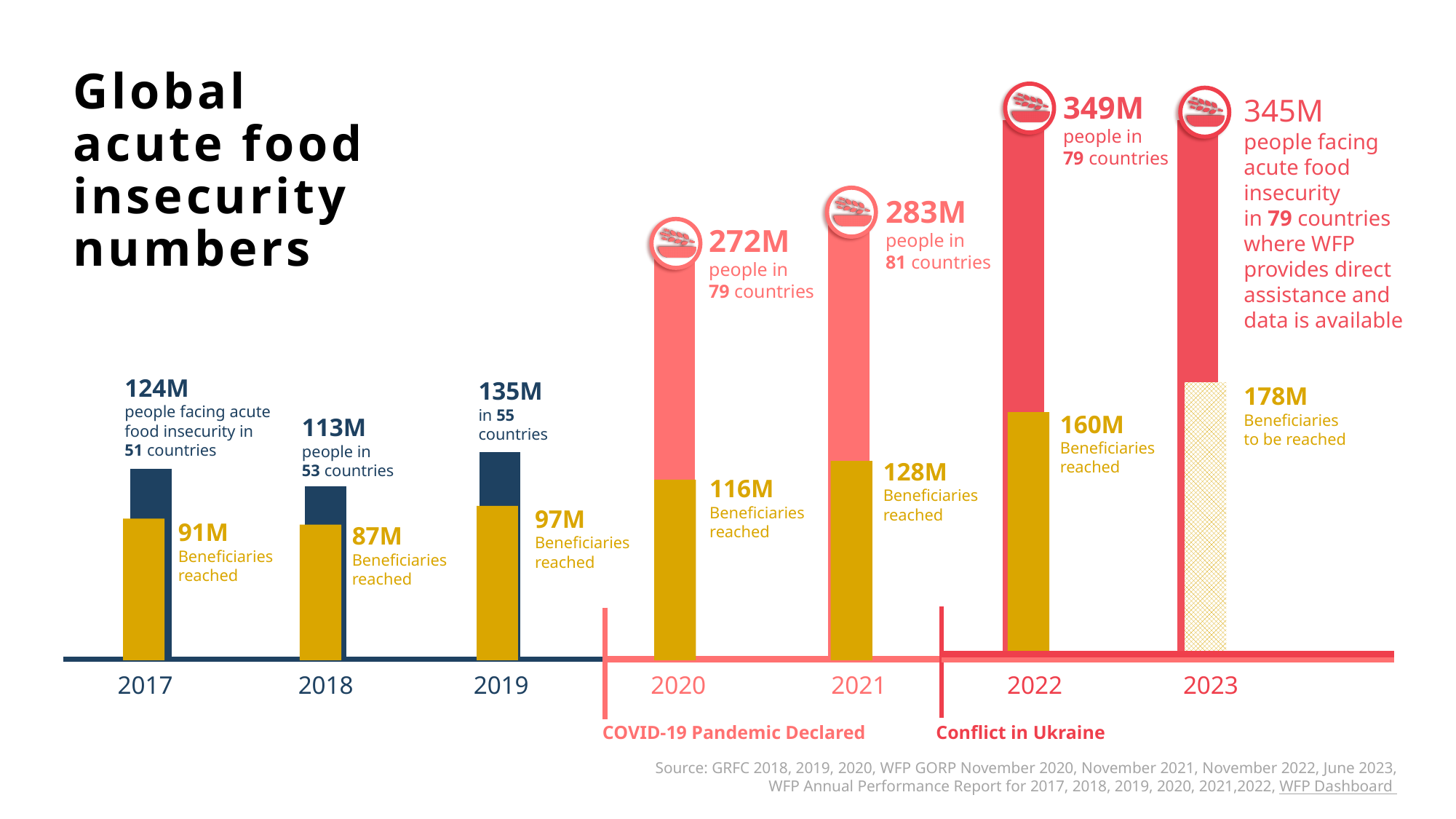
Which event is marked on the chart between 2019 and 2020? COVID-19 Pandemic Declared Which is larger: the number of beneficiaries reached in 2019 or in 2020? 2020 How many years are shown on the x axis of the chart? 7 How many beneficiaries were reached in 2021? 128M Which year has the lowest number of beneficiaries reached? 2018 What is the difference between the number of people facing acute food insecurity and the beneficiaries reached in 2022? 189M Do the numbers of people facing acute food insecurity rise or fall from 2019 to 2022? Rise In how many countries were people facing acute food insecurity in 2021? 81 How many people were facing acute food insecurity in 2017? 124M How many beneficiaries are to be reached in 2023? 178M What type of chart is shown on the slide? Bar chart Which year has the highest number of people facing acute food insecurity? 2022